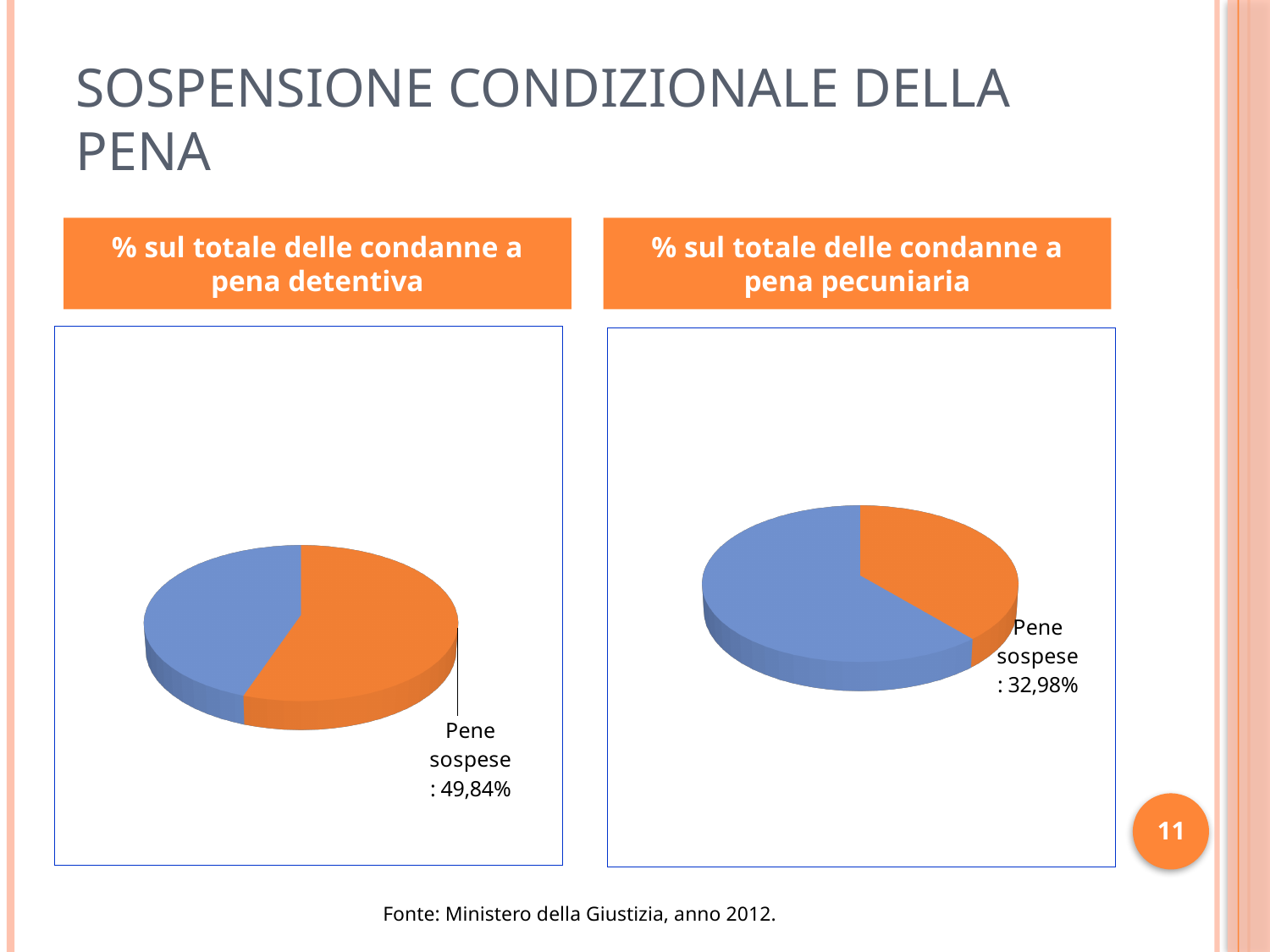
In the chart titled "% sul totale delle condanne a pena detentiva", what percentage is shown for Pene sospese? 49,84% In the left chart, "% sul totale delle condanne a pena detentiva", is the Pene sospese share greater or less than 50%? less What kind of chart is the left chart, "% sul totale delle condanne a pena detentiva"? Pie chart In the right chart, "% sul totale delle condanne a pena pecuniaria", is the Pene sospese share greater or less than 50%? less Which chart shows a larger share for Pene sospese: the one for pena detentiva or the one for pena pecuniaria? Pena detentiva How many slices does the left pie chart, "% sul totale delle condanne a pena detentiva", have? 2 What kind of chart is the right chart, "% sul totale delle condanne a pena pecuniaria"? Pie chart How many slices does the right pie chart, "% sul totale delle condanne a pena pecuniaria", have? 2 In the chart titled "% sul totale delle condanne a pena pecuniaria", what percentage is shown for Pene sospese? 32,98% What is the difference between the Pene sospese share in the pena detentiva chart and the Pene sospese share in the pena pecuniaria chart? 16,86 percentage points What is the title of the chart on the left side of the slide? % sul totale delle condanne a pena detentiva In the right chart, "% sul totale delle condanne a pena pecuniaria", what colour is the Pene sospese slice? Orange